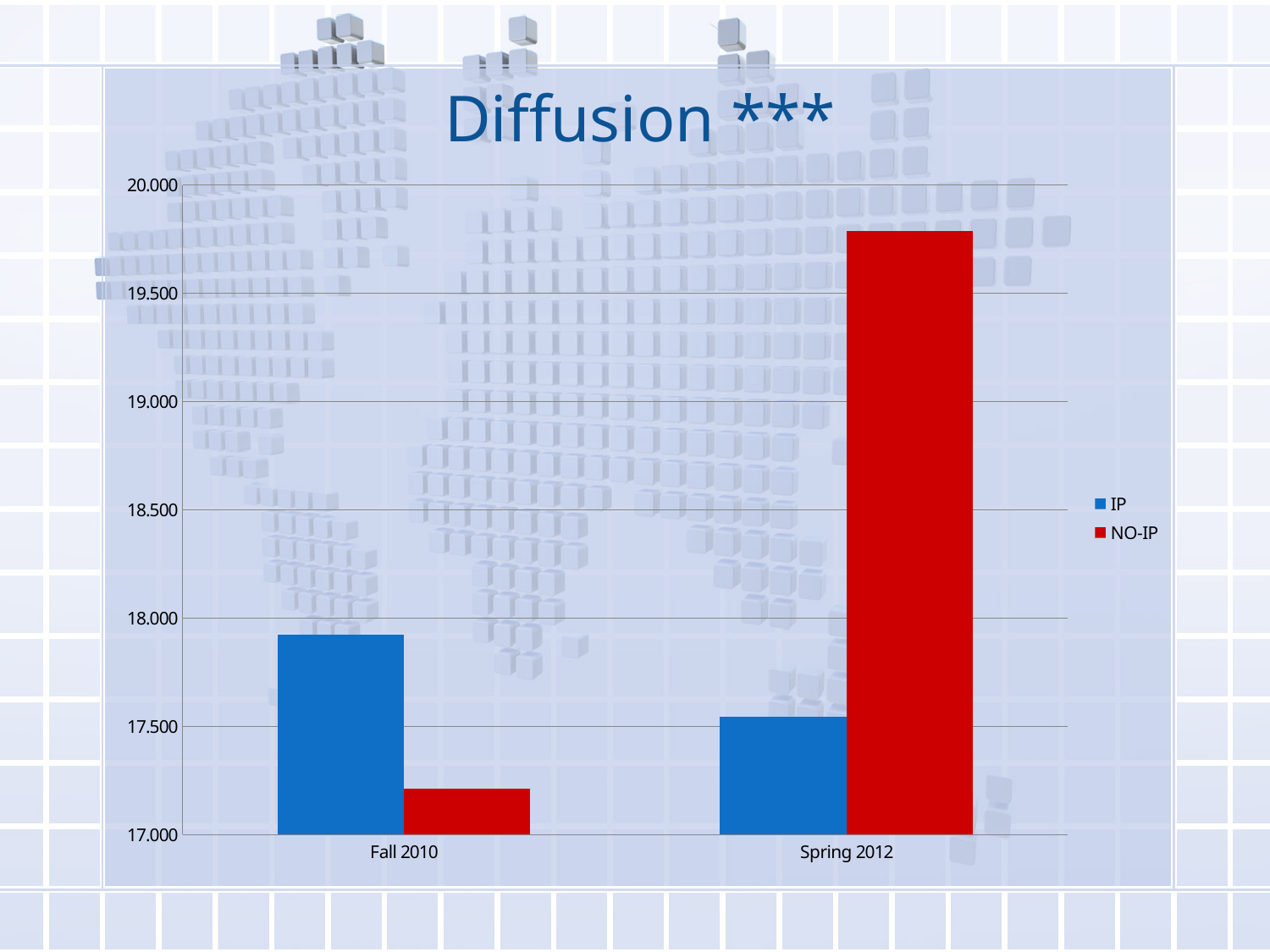
How many series does the legend list? 2 In Spring 2012, which series has the larger value, IP or NO-IP? NO-IP Which series is shown in red? NO-IP Which bar is the highest in the chart? NO-IP in Spring 2012 How many categories are shown on the x axis? 2 Is the value for NO-IP in Spring 2012 greater or less than 19.500? greater What kind of chart is shown on the slide? bar chart In Fall 2010, which series has the larger value, IP or NO-IP? IP Which bar is the lowest in the chart? NO-IP in Fall 2010 Does the IP series rise or fall from Fall 2010 to Spring 2012? fall What is the title of the chart? Diffusion *** Is the value for IP in Fall 2010 greater or less than 18.000? less